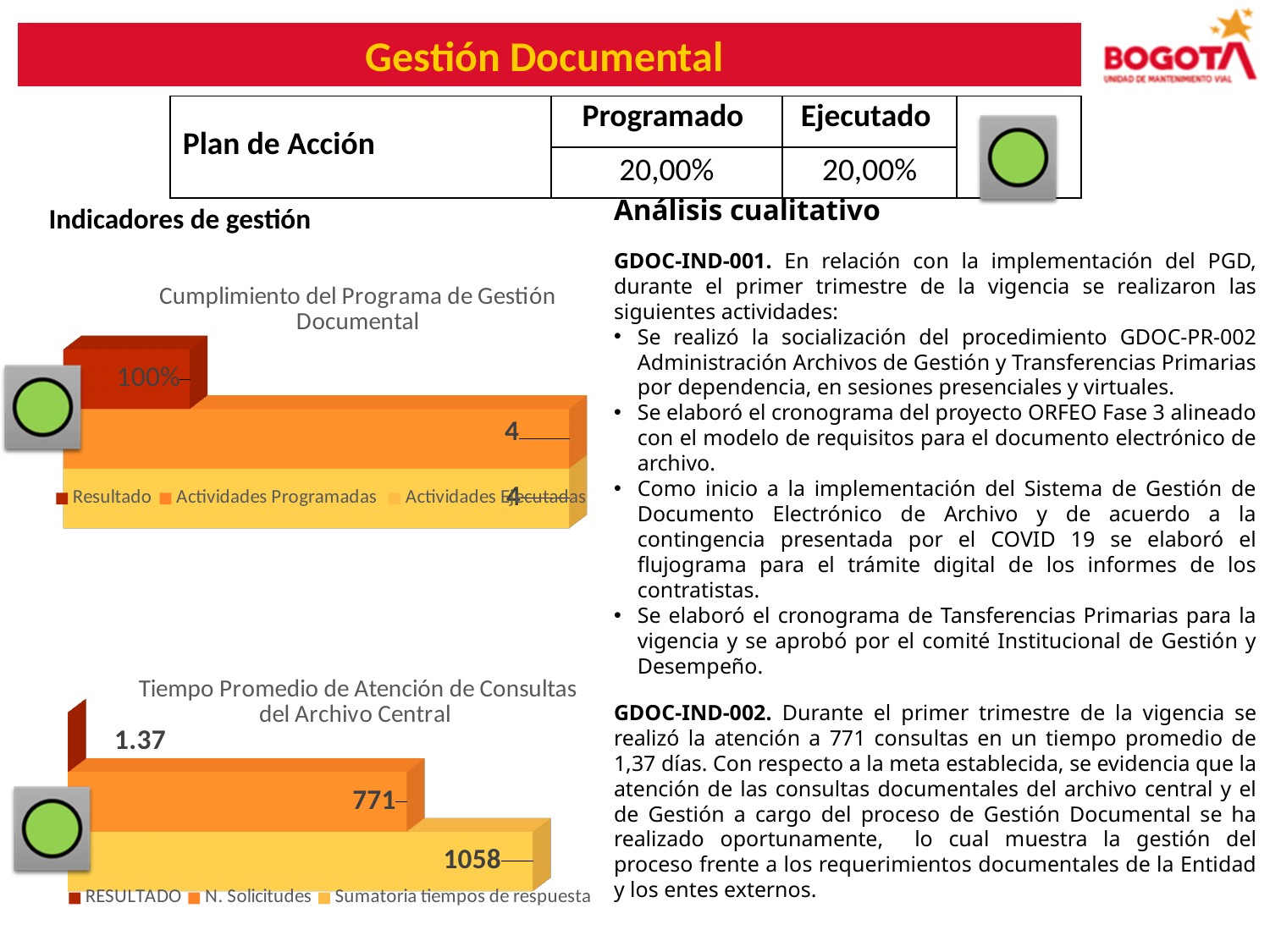
In the chart titled "Tiempo Promedio de Atención de Consultas del Archivo Central", what value is shown for Sumatoria tiempos de respuesta? 1058 In the chart titled "Tiempo Promedio de Atención de Consultas del Archivo Central", what value is shown for RESULTADO? 1.37 In the chart titled "Cumplimiento del Programa de Gestión Documental", what value is shown for Actividades Programadas? 4 In the chart titled "Cumplimiento del Programa de Gestión Documental", what value is shown for Resultado? 100% What kind of chart is "Cumplimiento del Programa de Gestión Documental"? Bar chart In the chart titled "Tiempo Promedio de Atención de Consultas del Archivo Central", which series has the highest value? Sumatoria tiempos de respuesta In the chart titled "Cumplimiento del Programa de Gestión Documental", what value is shown for Actividades Ejecutadas? 4 In the chart titled "Cumplimiento del Programa de Gestión Documental", how many series does the legend list? 3 In the chart titled "Tiempo Promedio de Atención de Consultas del Archivo Central", how many series does the legend list? 3 In the chart titled "Tiempo Promedio de Atención de Consultas del Archivo Central", which series has the lowest value? RESULTADO In the chart titled "Tiempo Promedio de Atención de Consultas del Archivo Central", what is the difference between Sumatoria tiempos de respuesta and N. Solicitudes? 287 In the chart titled "Tiempo Promedio de Atención de Consultas del Archivo Central", what value is shown for N. Solicitudes? 771